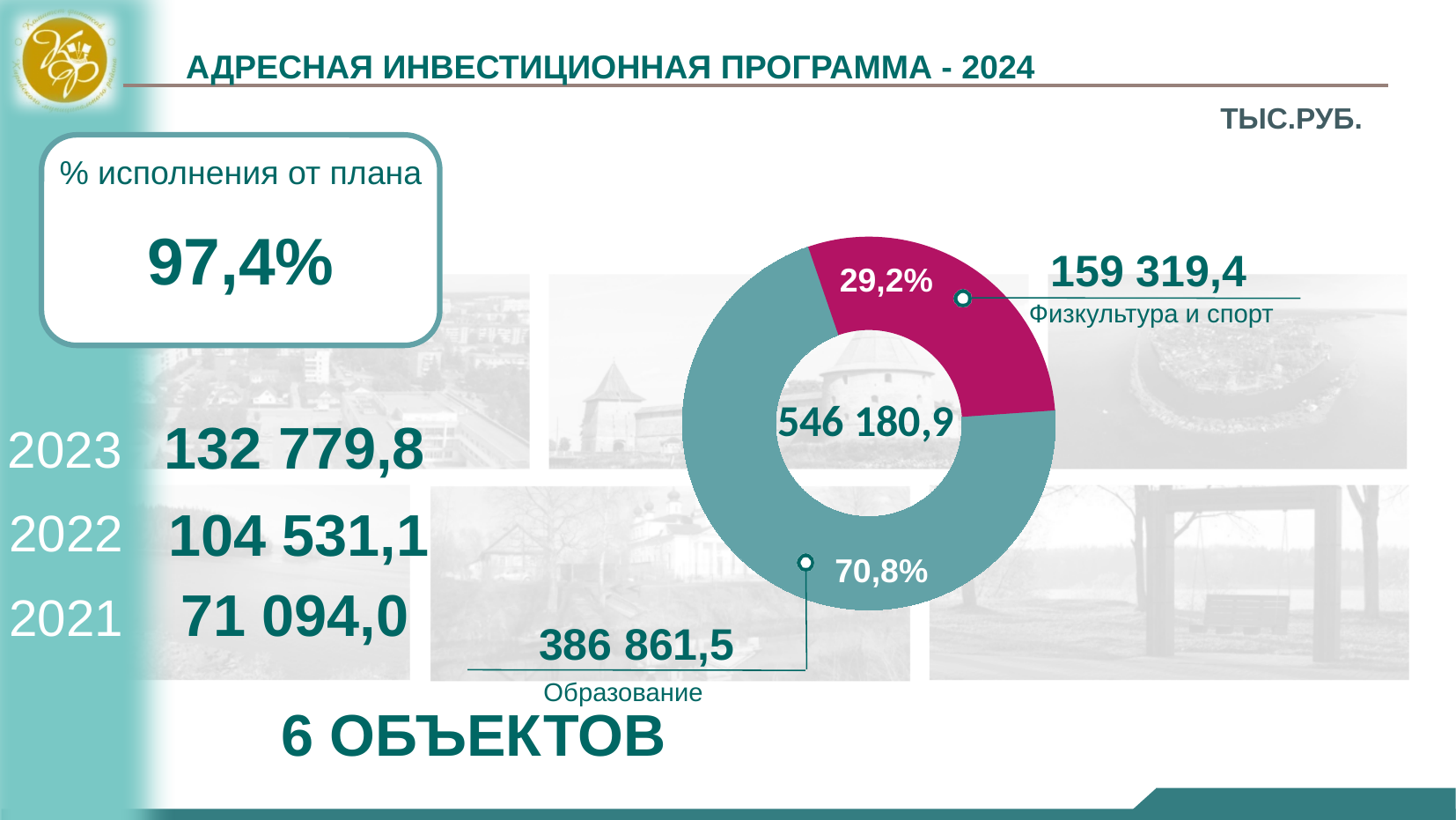
What colour is the Физкультура и спорт slice in the donut chart? Magenta What total is shown in the centre of the donut chart? 546 180,9 What is the difference between the values for Образование and Физкультура и спорт? 227 542,1 What is the value for Физкультура и спорт? 159 319,4 What is the value for Образование? 386 861,5 What share of the donut chart does Физкультура и спорт represent? 29,2% What kind of chart is shown on the slide? Pie (donut) chart How many slices does the donut chart have? 2 Which is larger, the value for Образование or the value for Физкультура и спорт? Образование Which category has the smallest slice in the donut chart? Физкультура и спорт What share of the donut chart does Образование represent? 70,8% Which category has the largest slice in the donut chart? Образование